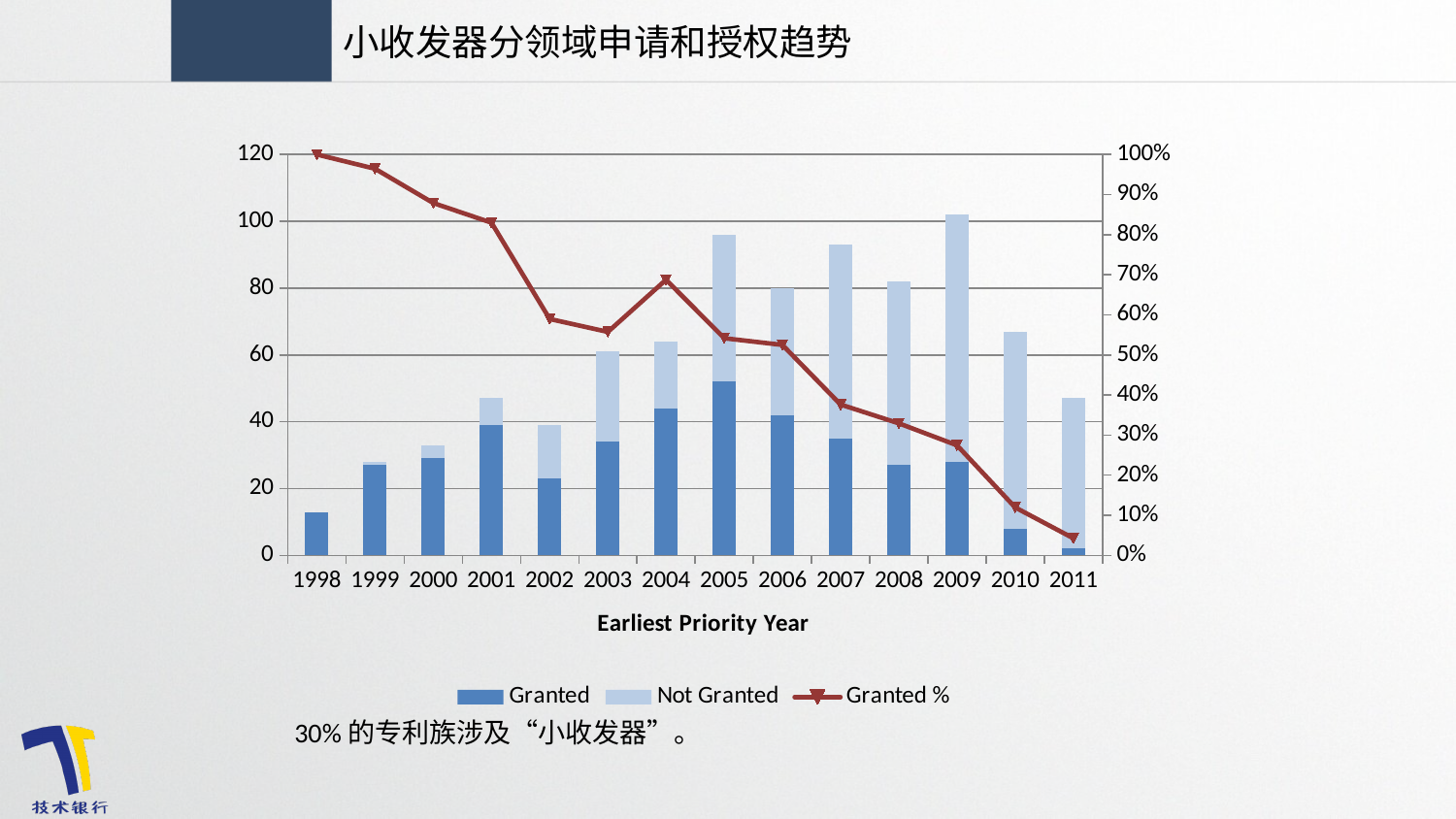
Which year has the tallest stacked bar (Granted plus Not Granted)? 2009 What kind of chart is shown on the slide? A stacked bar chart combined with a line chart Is the Granted % value for 2011 greater or less than 10%? less Does the Granted % line rise or fall overall from 1998 to 2011? fall Is the Granted % value for 2004 greater or less than 60%? greater Which year has the lowest Granted value? 2011 Which year has the shortest stacked bar? 1998 How many series does the legend list? 3 Which year has the highest Granted value? 2005 Is the total stacked bar for 2007 greater or less than 80? greater What is the x axis title of the chart? Earliest Priority Year How many years are shown on the x axis? 14